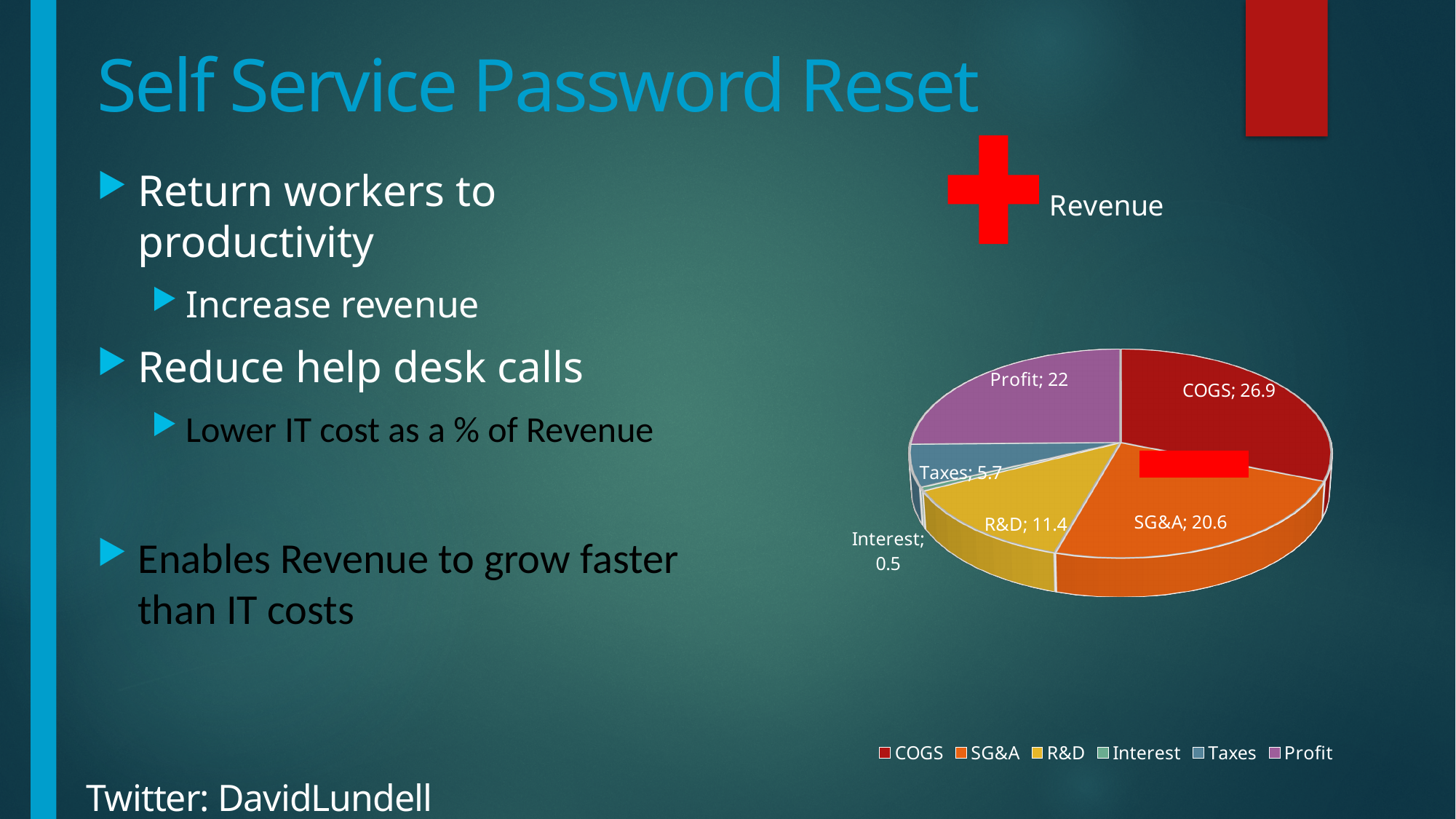
Which category has the largest slice in the pie chart? COGS Which is larger in the pie chart, Profit or R&D? Profit Which category has the smallest slice in the pie chart? Interest What is the value for SG&A in the pie chart? 20.6 What is the value for COGS in the pie chart? 26.9 What is the difference between the Profit value and the Taxes value in the pie chart? 16.3 What is the value for Interest in the pie chart? 0.5 Which category is shown in purple in the pie chart? Profit What is the value for Taxes in the pie chart? 5.7 What is the difference between the COGS value and the SG&A value in the pie chart? 6.3 How many categories does the pie chart show? 6 What kind of chart is shown on the slide? Pie chart